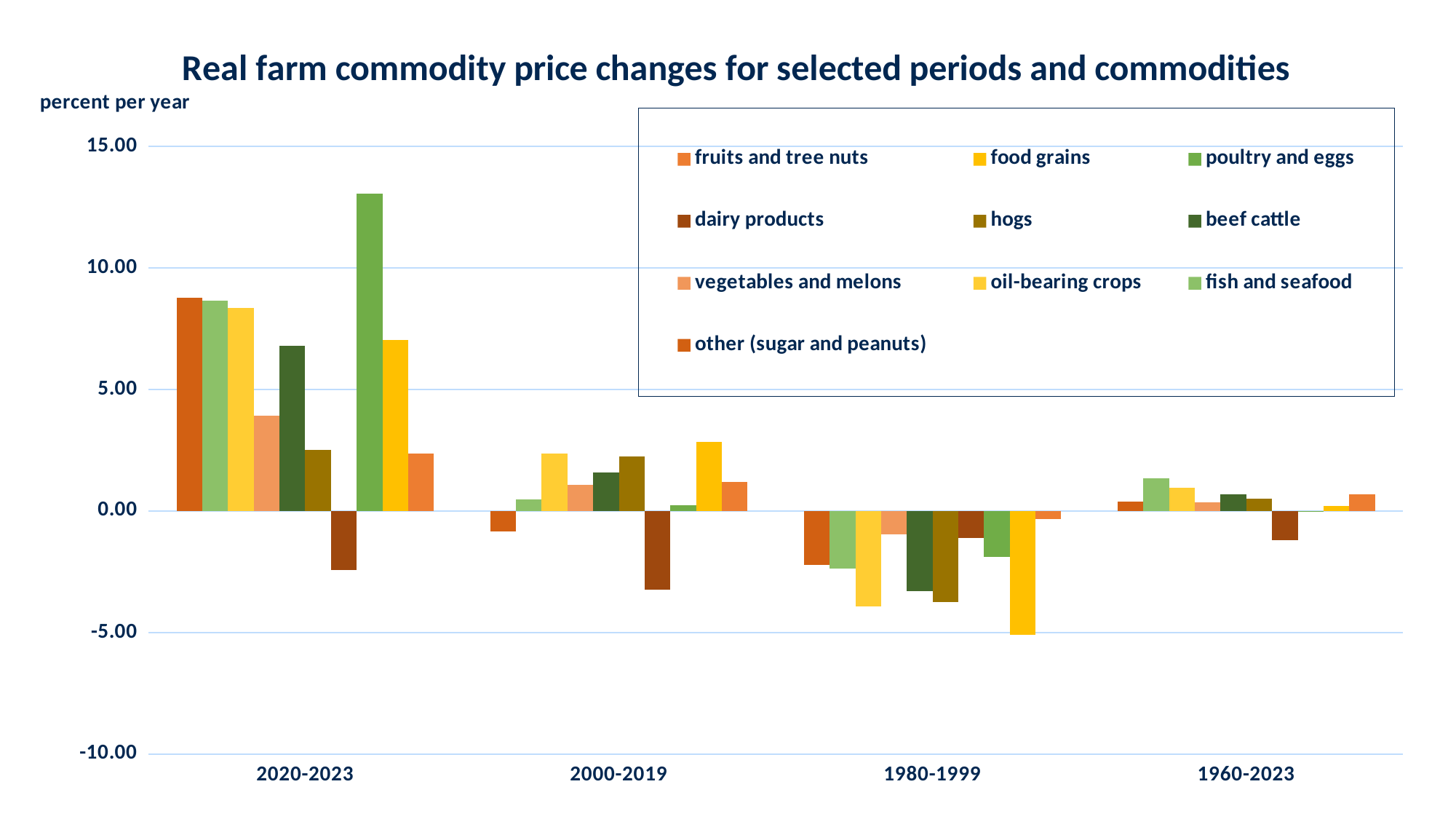
Is the value for hogs in 1980-1999 greater or less than 0.00? less Is the value for dairy products in 2020-2023 greater or less than 0.00? less Is the lowest bar in the 1980-1999 period greater or less than -4.00? less What is the title of the chart? Real farm commodity price changes for selected periods and commodities Which period contains the tallest bar in the chart? 2020-2023 How many series does the legend list? 10 What unit label is shown above the vertical axis? percent per year How many time periods are shown along the x axis? 4 For beef cattle, which period has the larger value: 2020-2023 or 2000-2019? 2020-2023 What kind of chart is shown on the slide? bar chart